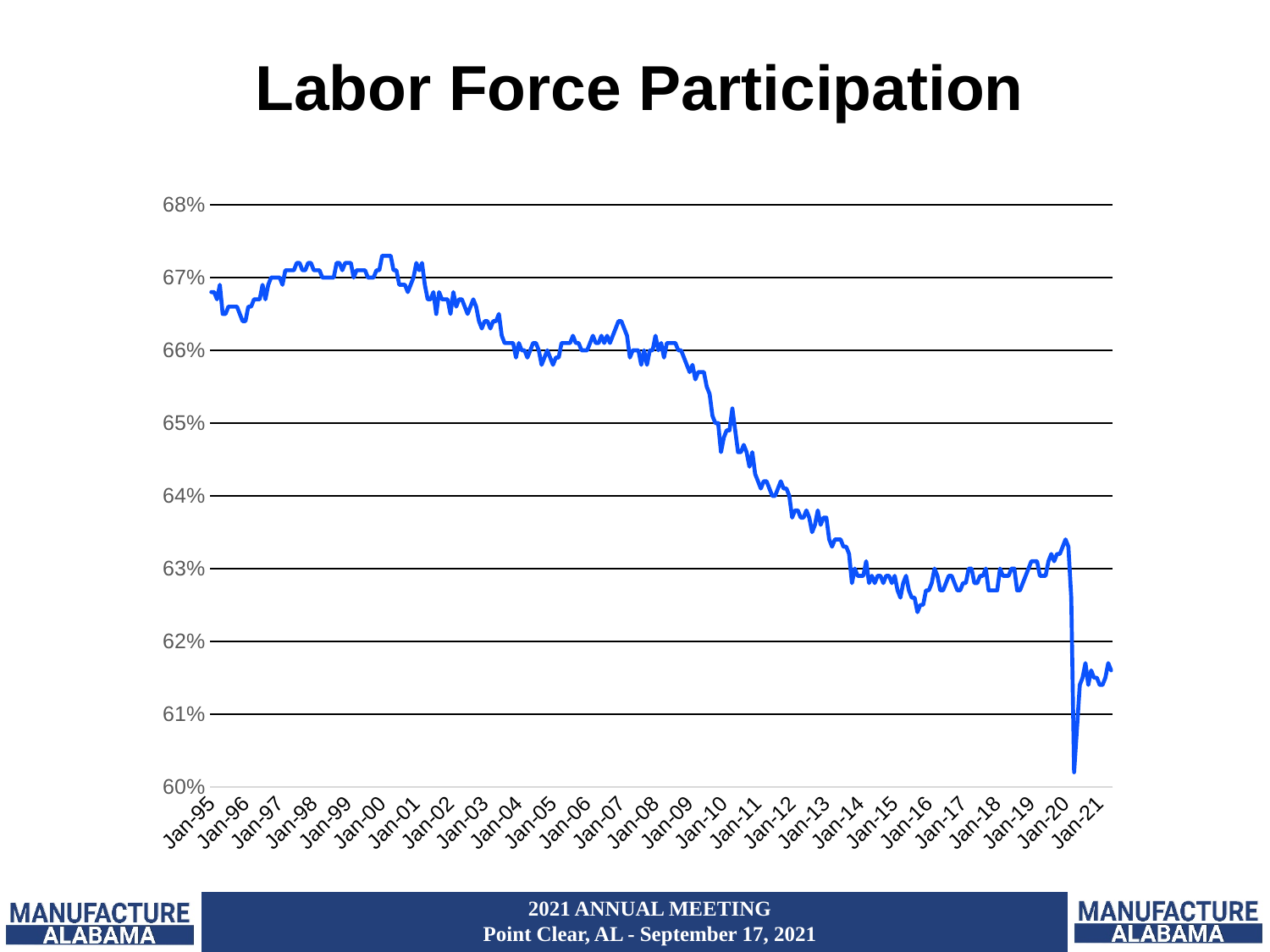
Is the value at Jan-13 greater or less than 64%? less Is the value at Jan-16 greater or less than 63%? less How many labelled tick marks are on the x axis? 27 Which is larger, the value at Jan-95 or the value at Jan-21? Jan-95 Is the value at Jan-09 greater or less than 65%? greater In which year does the line reach its lowest point? 2020 What kind of chart is shown on the slide? line chart What is the title of the chart? Labor Force Participation Overall, does the labor force participation rate rise or fall from Jan-95 to Jan-21? fall